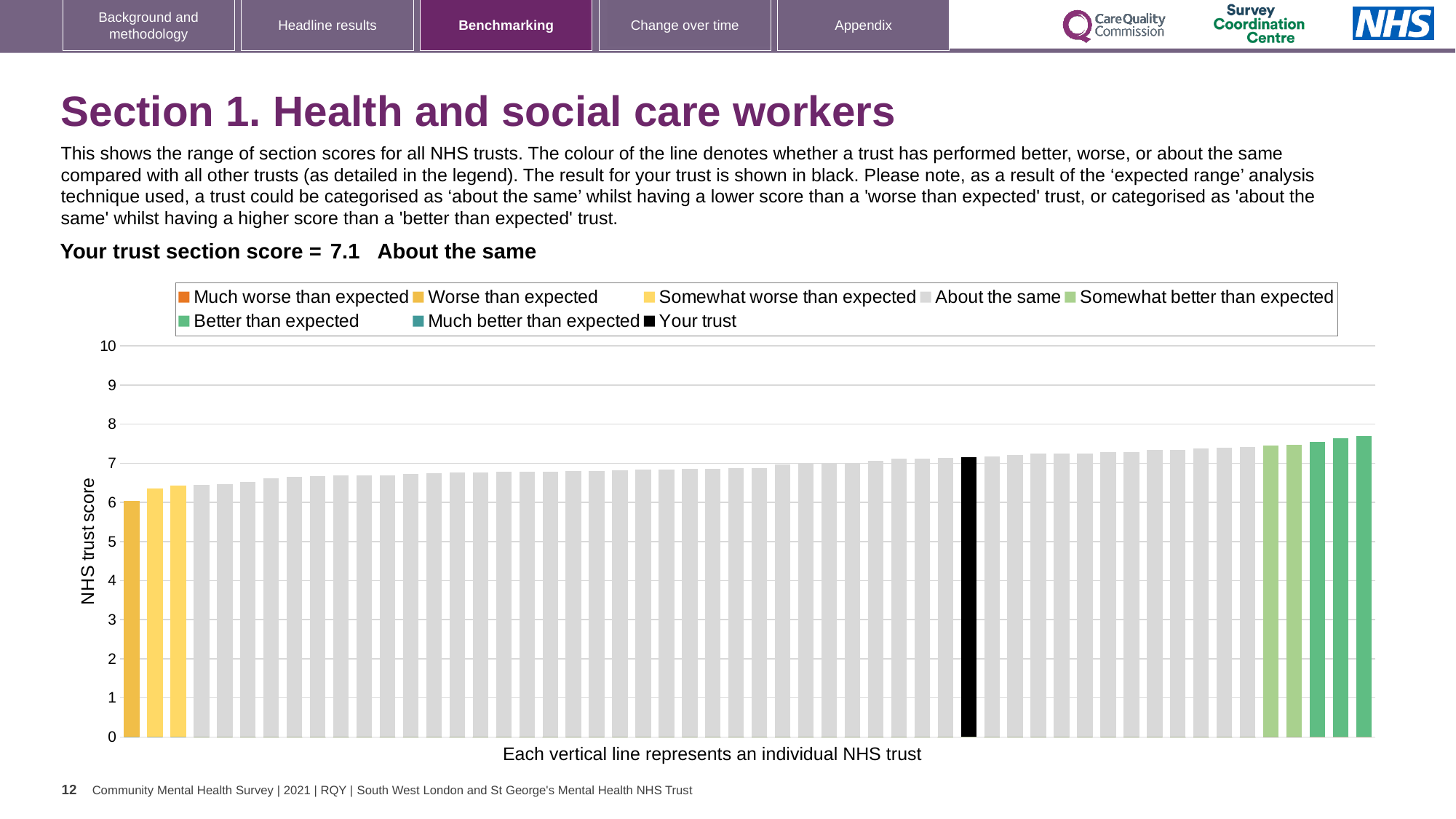
Do the bar values rise or fall from left to right along the x axis? rise How many bars are coloured as 'Better than expected'? 3 How many entries does the chart legend list? 8 Is the value of the highest bar greater or less than 8? less Is the value of the lowest bar greater or less than 7? less How many bars are coloured as 'Somewhat better than expected'? 2 What is the section score for your trust shown on the slide? 7.1 What kind of chart is shown on the slide? bar chart What is the label on the y axis of the chart? NHS trust score Is the value of the highest bar greater or less than 7? greater How many bars are coloured as 'Worse than expected'? 1 What colour is the bar representing your trust? black